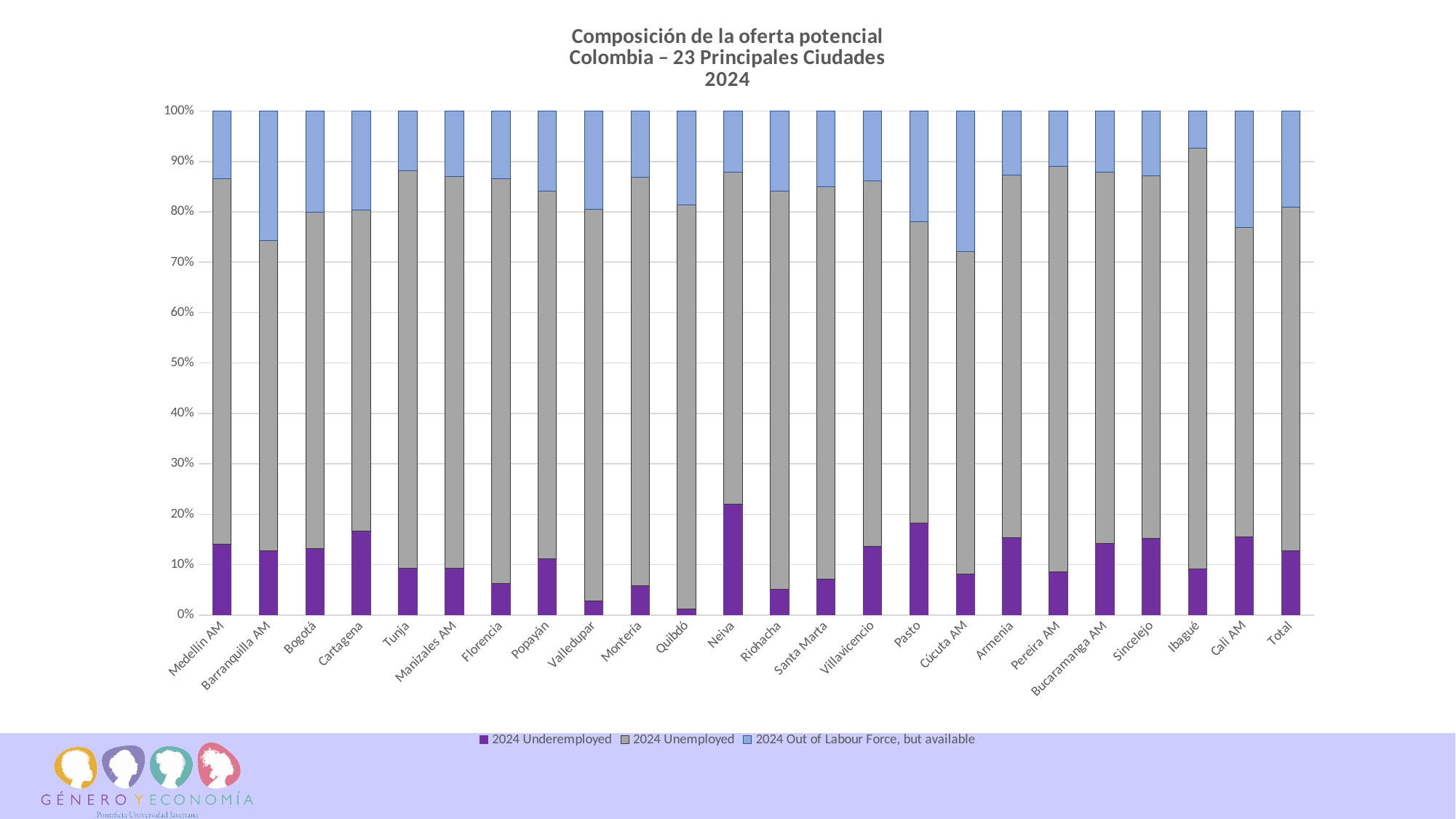
Is the value for 2024 Underemployed in Neiva greater or less than 10%? greater Which category has the lowest value for 2024 Underemployed? Quibdó Is the value for 2024 Underemployed in Valledupar greater or less than 10%? less Which category has the highest value for 2024 Underemployed? Neiva What is the total of the stacked bar for Bogotá? 100% Is the value for 2024 Underemployed in Pasto greater or less than 10%? greater How many categories are shown along the x axis? 24 How many series does the legend list? 3 What is the title of the chart? Composición de la oferta potencial Colombia – 23 Principales Ciudades 2024 Which category has the smallest 2024 Out of Labour Force, but available segment? Ibagué Which is larger, the 2024 Underemployed value for Cartagena or for Tunja? Cartagena What kind of chart is shown on the slide? Stacked bar chart